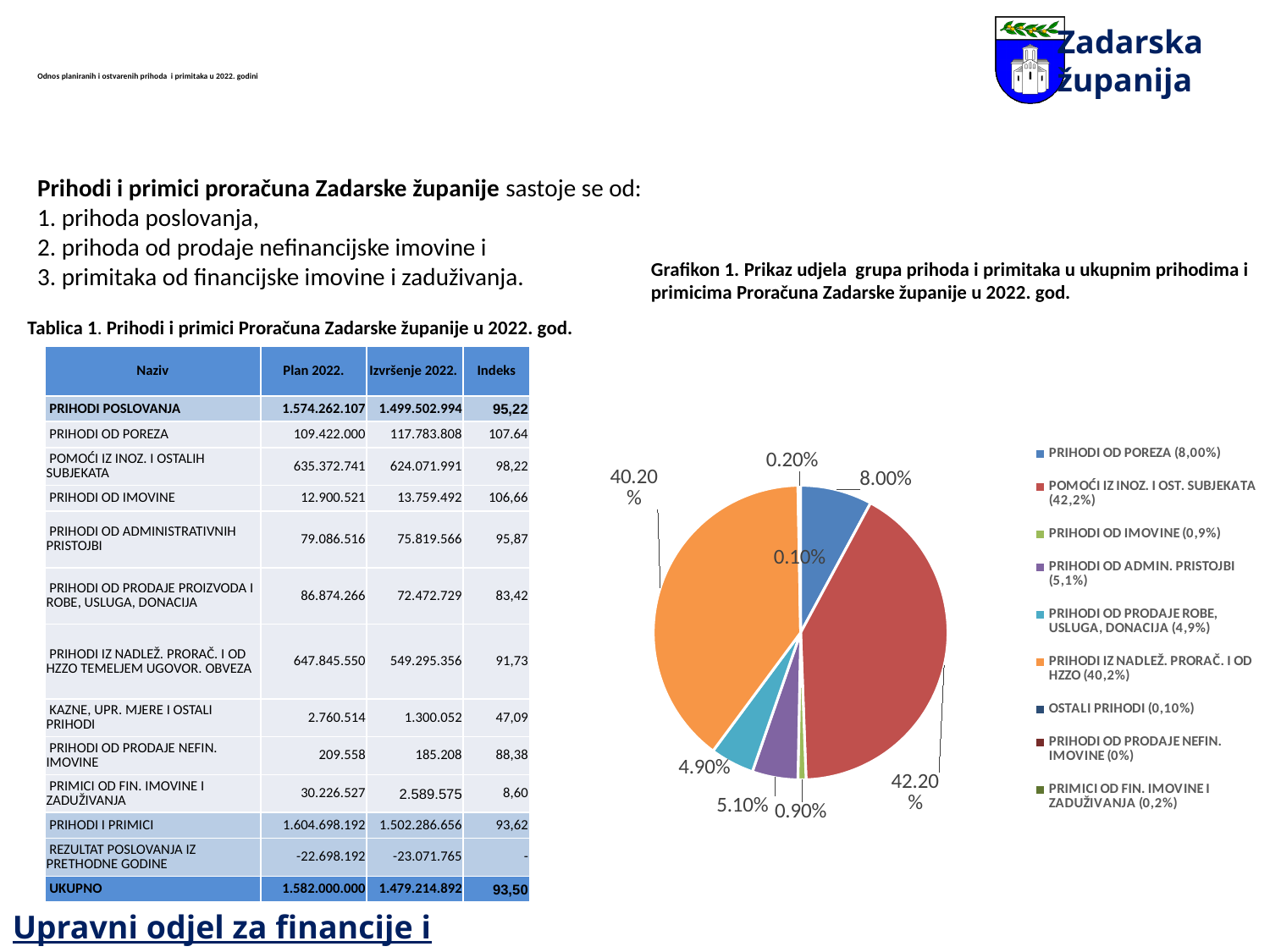
What share of the pie does PRIHODI OD ADMIN. PRISTOJBI have? 5.10% What is the difference in share between POMOĆI IZ INOZ. I OST. SUBJEKATA and PRIHODI IZ NADLEŽ. PRORAČ. I OD HZZO? 2.00% Which has a larger share, PRIHODI OD POREZA or PRIHODI OD ADMIN. PRISTOJBI? PRIHODI OD POREZA What kind of chart is shown on the slide? pie chart Which category has the smallest share according to the legend? PRIHODI OD PRODAJE NEFIN. IMOVINE What share of the pie does PRIHODI OD PRODAJE ROBE, USLUGA, DONACIJA have? 4.90% What share of the pie does PRIHODI OD POREZA have? 8.00% How many entries does the legend of the pie chart list? 9 What share of the pie does POMOĆI IZ INOZ. I OST. SUBJEKATA have? 42.20% Which category has the largest slice of the pie? POMOĆI IZ INOZ. I OST. SUBJEKATA What is the title of the pie chart? Grafikon 1. Prikaz udjela grupa prihoda i primitaka u ukupnim prihodima i primicima Proračuna Zadarske županije u 2022. god. What share of the pie does PRIHODI IZ NADLEŽ. PRORAČ. I OD HZZO have? 40.20%